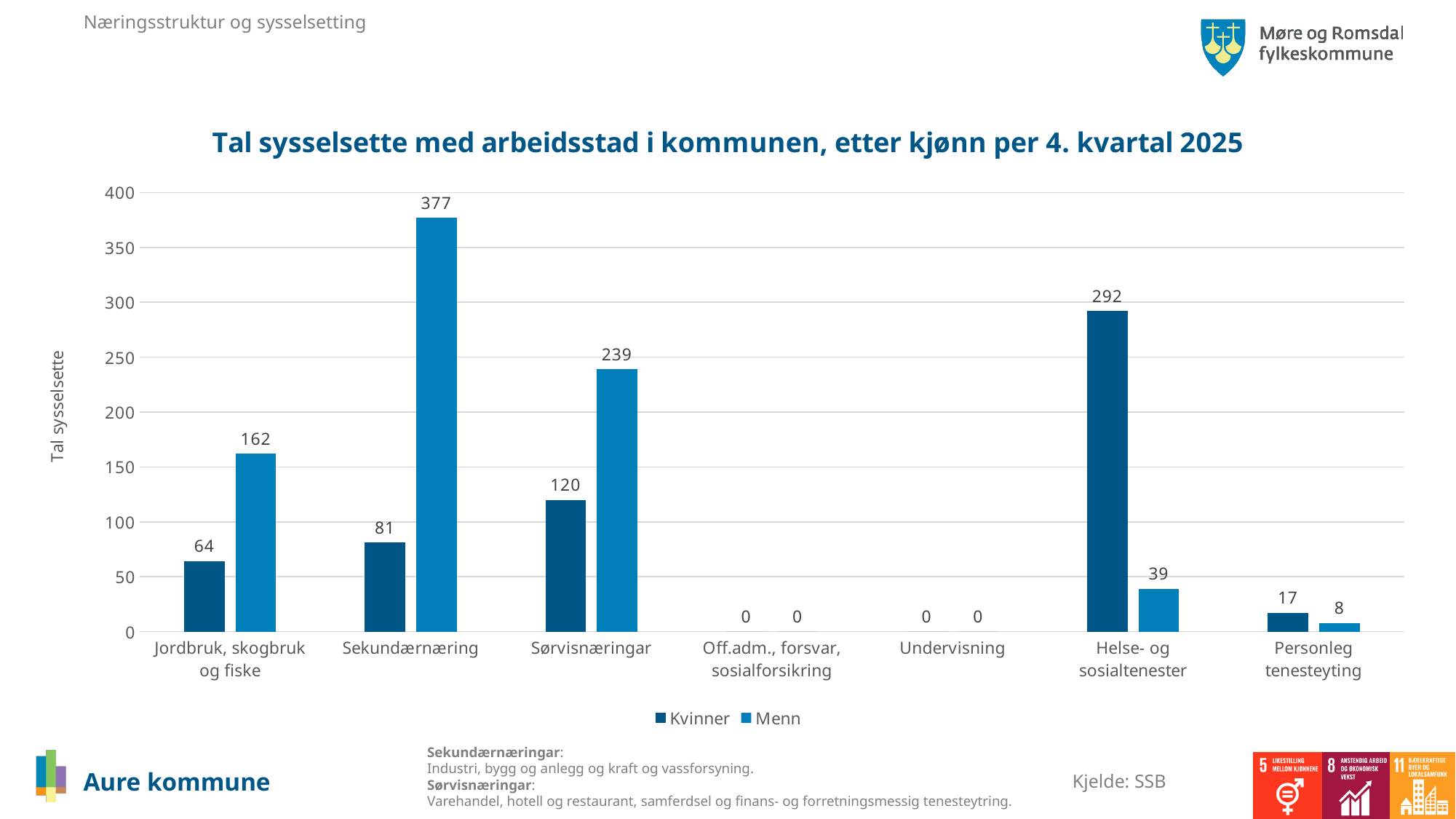
Which category has the highest value for Menn? Sekundærnæring How many categories are shown on the x axis? 7 What is the value for Kvinner in Jordbruk, skogbruk og fiske? 64 What kind of chart is shown on the slide? Bar chart How many series does the legend list? 2 Which is larger in Personleg tenesteyting, Kvinner or Menn? Kvinner What is the difference between Menn and Kvinner in Sørvisnæringar? 119 Which category has the highest value for Kvinner? Helse- og sosialtenester What is the title of the chart? Tal sysselsette med arbeidsstad i kommunen, etter kjønn per 4. kvartal 2025 What is the value for Kvinner in Helse- og sosialtenester? 292 What is the total of Kvinner and Menn in Jordbruk, skogbruk og fiske? 226 What is the value for Menn in Sekundærnæring? 377